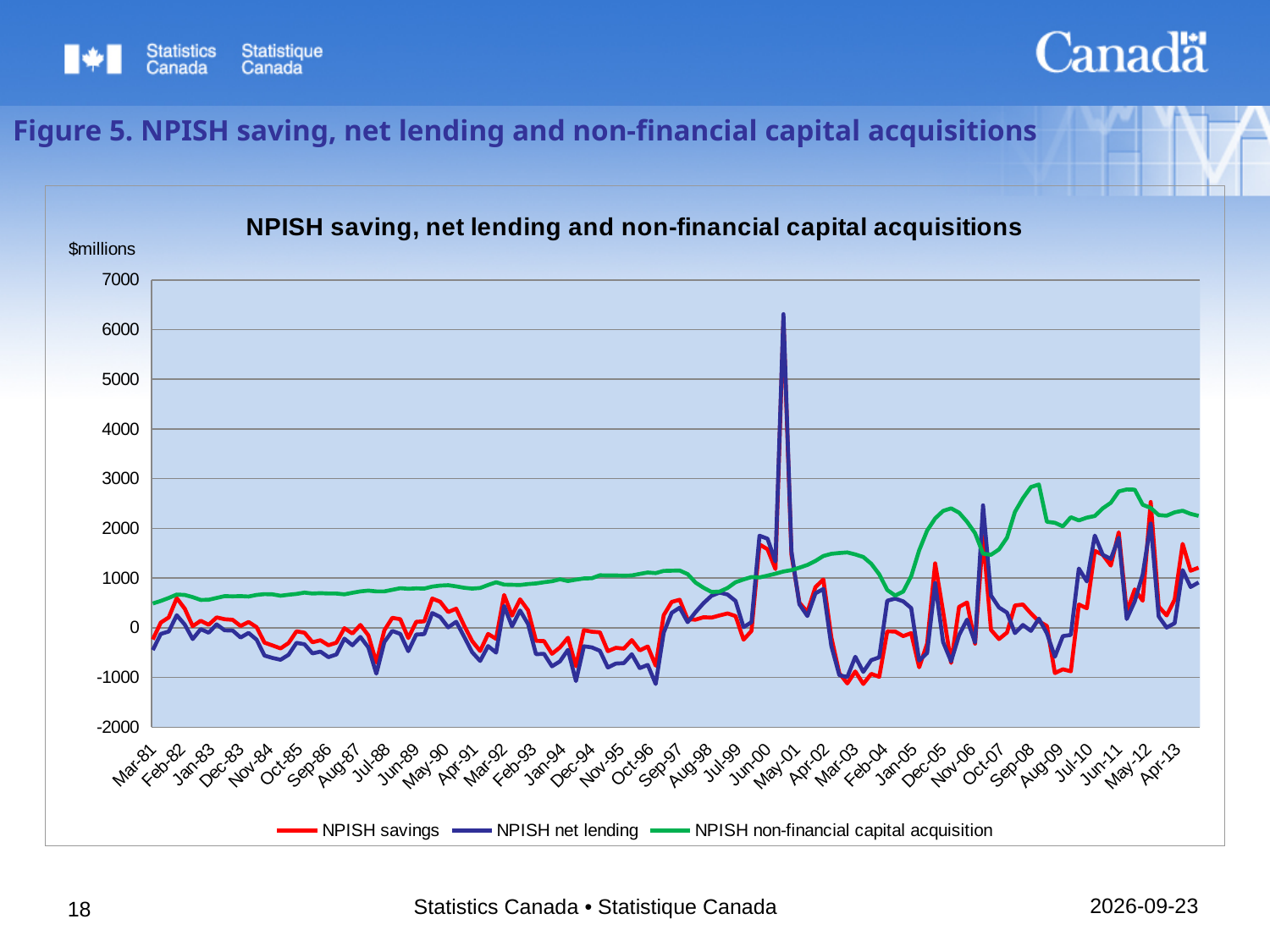
Is the peak value of NPISH net lending around May-01 greater or less than 6000? greater What is the title of the chart? NPISH saving, net lending and non-financial capital acquisitions How many series does the legend list? 3 Does NPISH non-financial capital acquisition generally rise or fall from Mar-81 to Apr-13? rise What is the highest value shown on the vertical axis? 7000 Is the value of NPISH non-financial capital acquisition around Sep-08 greater or less than 2000? greater Is the value of NPISH non-financial capital acquisition at Mar-81 greater or less than 1000? less What unit is shown on the vertical axis of the chart? $millions Which series reaches the highest value anywhere on the chart? NPISH net lending Around Sep-08, which is higher: NPISH non-financial capital acquisition or NPISH savings? NPISH non-financial capital acquisition What kind of chart is shown on the slide? Line chart